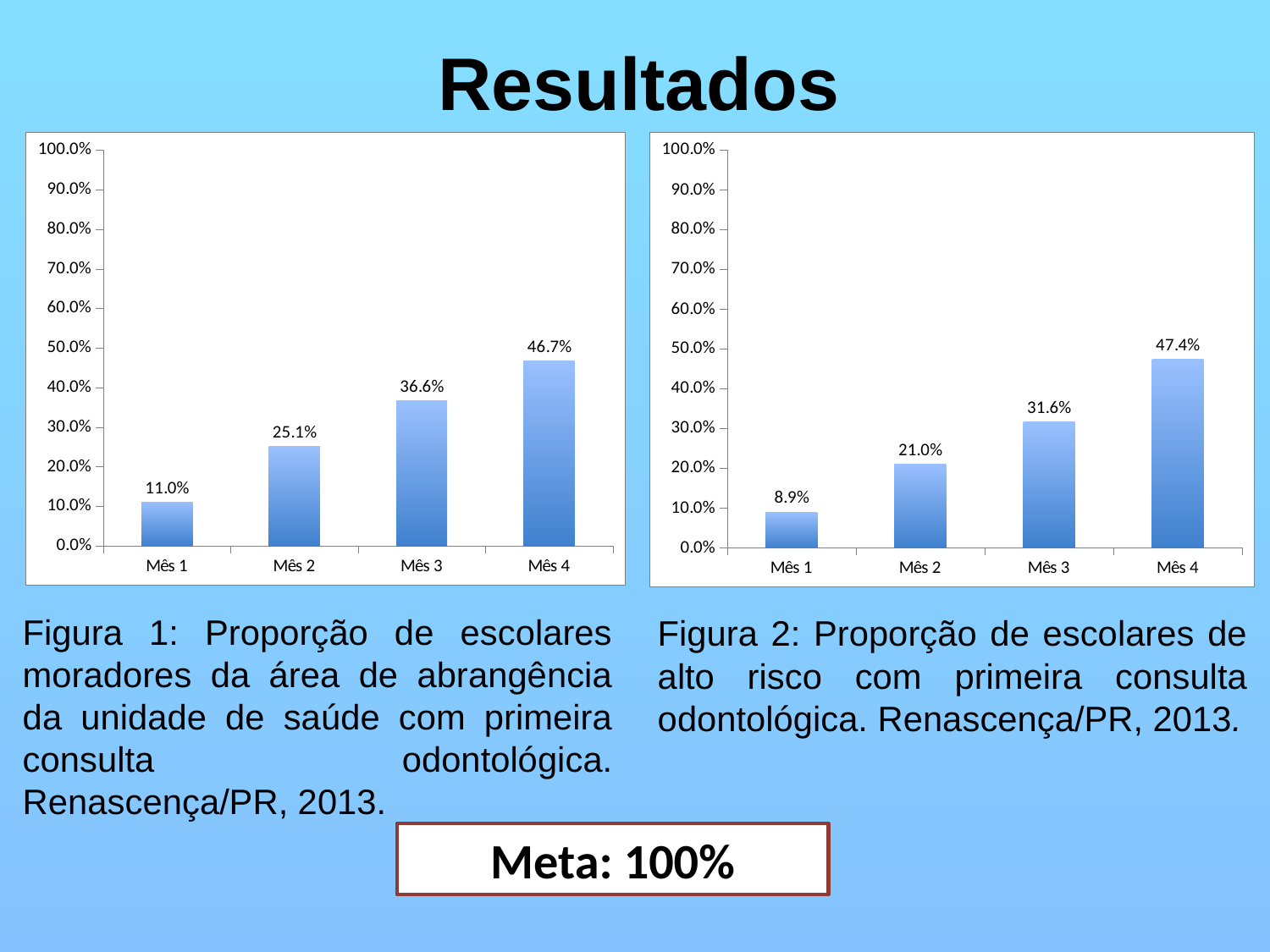
In the left chart (Figura 1), do the values rise or fall from Mês 1 to Mês 4? rise In the right chart (Figura 2), which month has the lowest value? Mês 1 In the left chart (Figura 1), what is the value for Mês 3? 36.6% In the right chart (Figura 2), is the value for Mês 4 greater or less than 50.0%? less In the left chart (Figura 1), what is the difference between the values for Mês 4 and Mês 1? 35.7% What is the maximum value shown on the y axis of the right chart (Figura 2)? 100.0% Which is larger: the value for Mês 2 in the left chart (Figura 1) or the value for Mês 2 in the right chart (Figura 2)? Mês 2 in the left chart (Figura 1) How many months are shown on the x axis of the left chart (Figura 1)? 4 In the left chart (Figura 1), which month has the highest value? Mês 4 In the right chart (Figura 2), what is the value for Mês 1? 8.9% In the right chart (Figura 2), what is the difference between the values for Mês 3 and Mês 2? 10.6% What kind of chart is the right chart (Figura 2)? bar chart